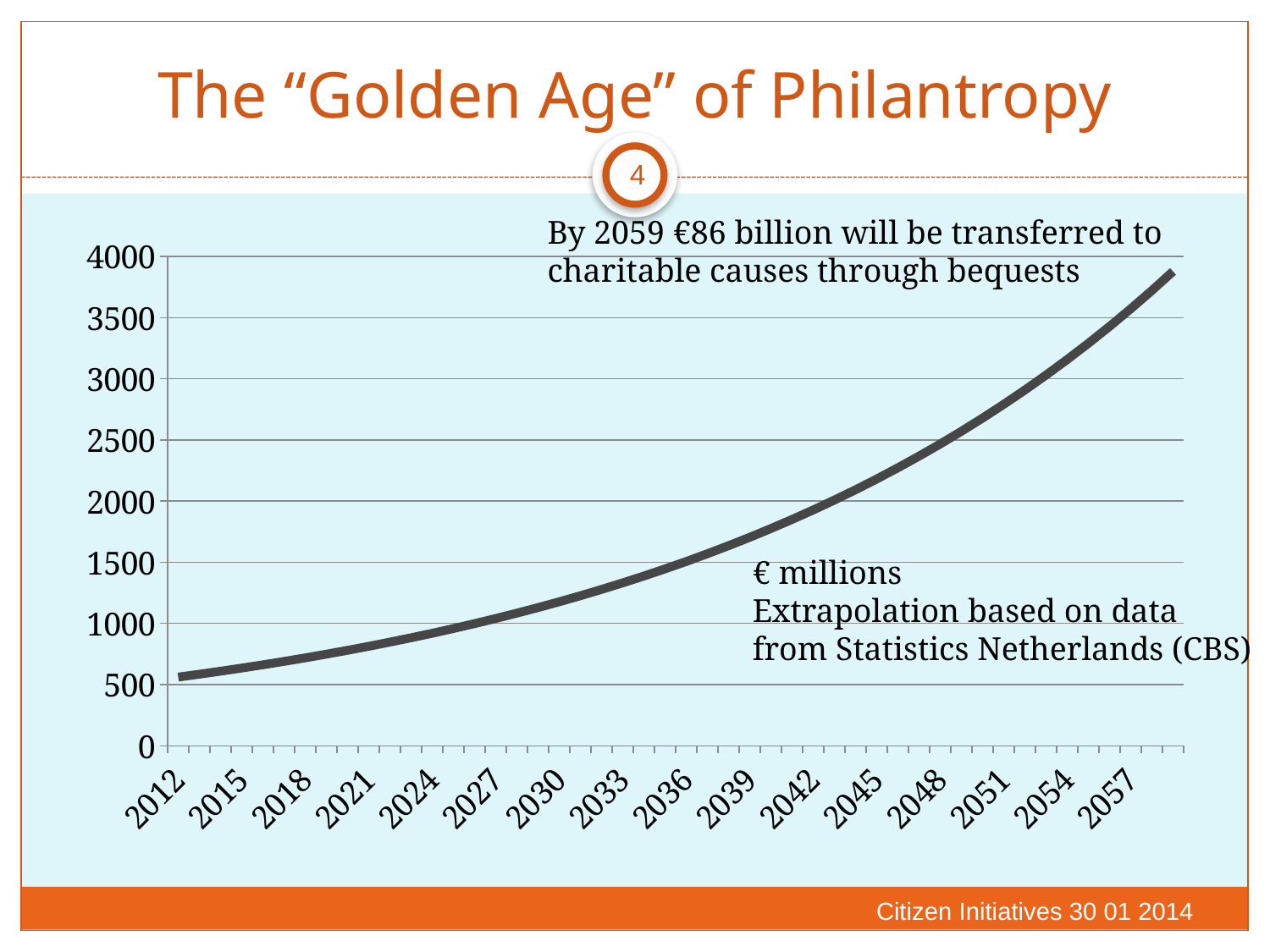
Which year on the x axis has the lowest value on the chart? 2012 Is the value for 2057 greater or less than 4000? less Is the value for 2051 greater or less than 2500? greater Is the value for 2012 greater or less than 1000? less In what unit are the values on the chart expressed, according to the text on the slide? € millions How many year labels are shown on the x axis of the chart? 16 What kind of chart is shown on the slide? line chart Do the values on the chart rise or fall from 2012 to 2057? rise Which has the larger value on the chart, 2021 or 2045? 2045